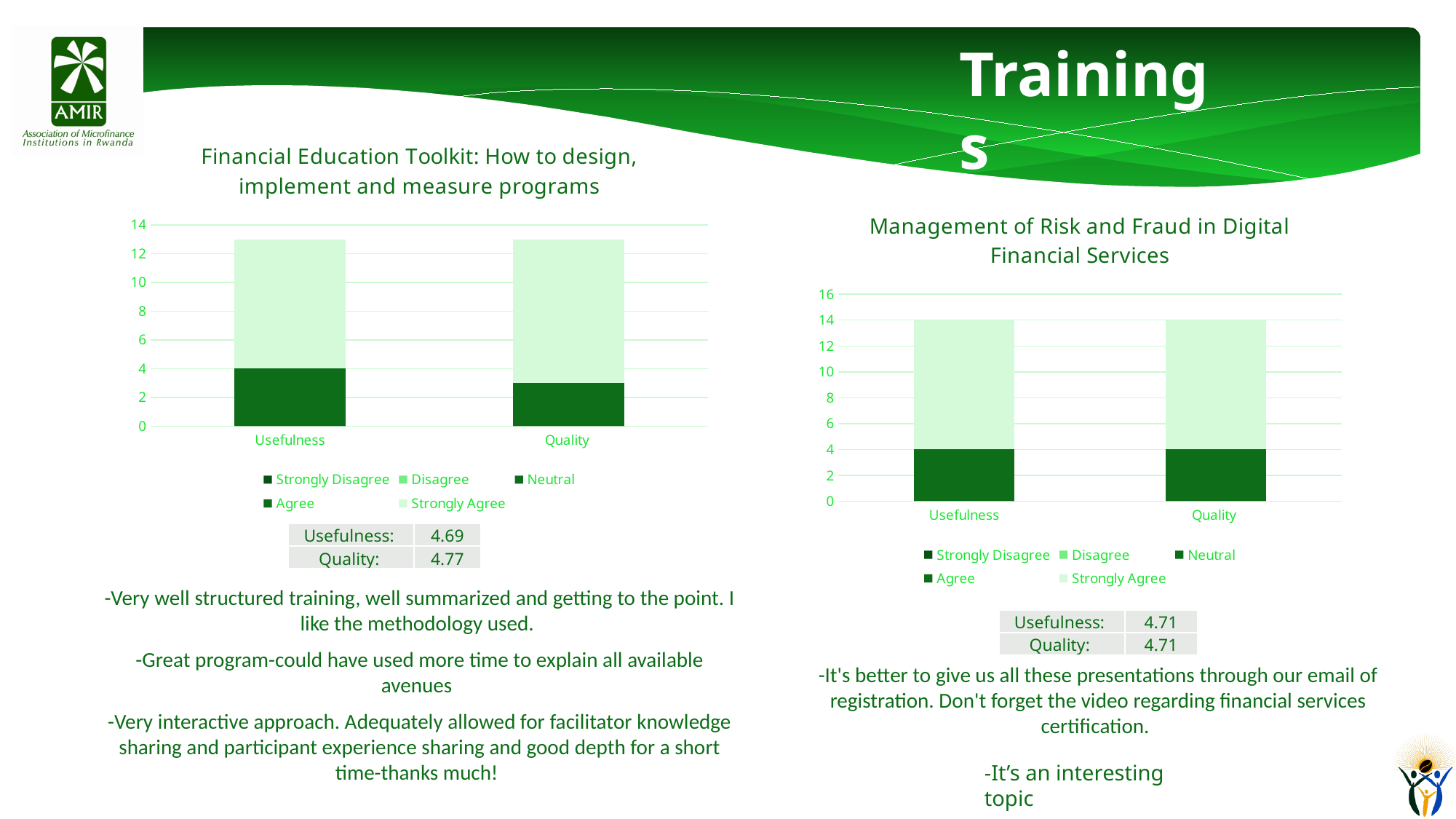
On the 'Financial Education Toolkit' chart, what is the value of the Agree segment for Usefulness? 4 What is the highest value shown on the y axis of the 'Management of Risk and Fraud in Digital Financial Services' chart? 16 How many categories are shown on the x axis of the 'Management of Risk and Fraud in Digital Financial Services' chart? 2 On the 'Management of Risk and Fraud in Digital Financial Services' chart, what is the value of the Strongly Agree segment for Usefulness? 10 How many series does the legend of the 'Financial Education Toolkit' chart list? 5 What kind of chart is the 'Management of Risk and Fraud in Digital Financial Services' chart? Stacked bar chart On the 'Management of Risk and Fraud in Digital Financial Services' chart, what is the value of the Agree segment for Quality? 4 On the 'Financial Education Toolkit' chart, is the total height of the Usefulness bar greater or less than 12? greater On the 'Financial Education Toolkit' chart, which category has the larger Agree segment, Usefulness or Quality? Usefulness On the 'Financial Education Toolkit' chart, is the Agree segment for Quality greater or less than 4? less Which legend entry on the 'Financial Education Toolkit' chart is shown in the lightest green? Strongly Agree On the 'Management of Risk and Fraud in Digital Financial Services' chart, what is the total height of the Usefulness bar? 14